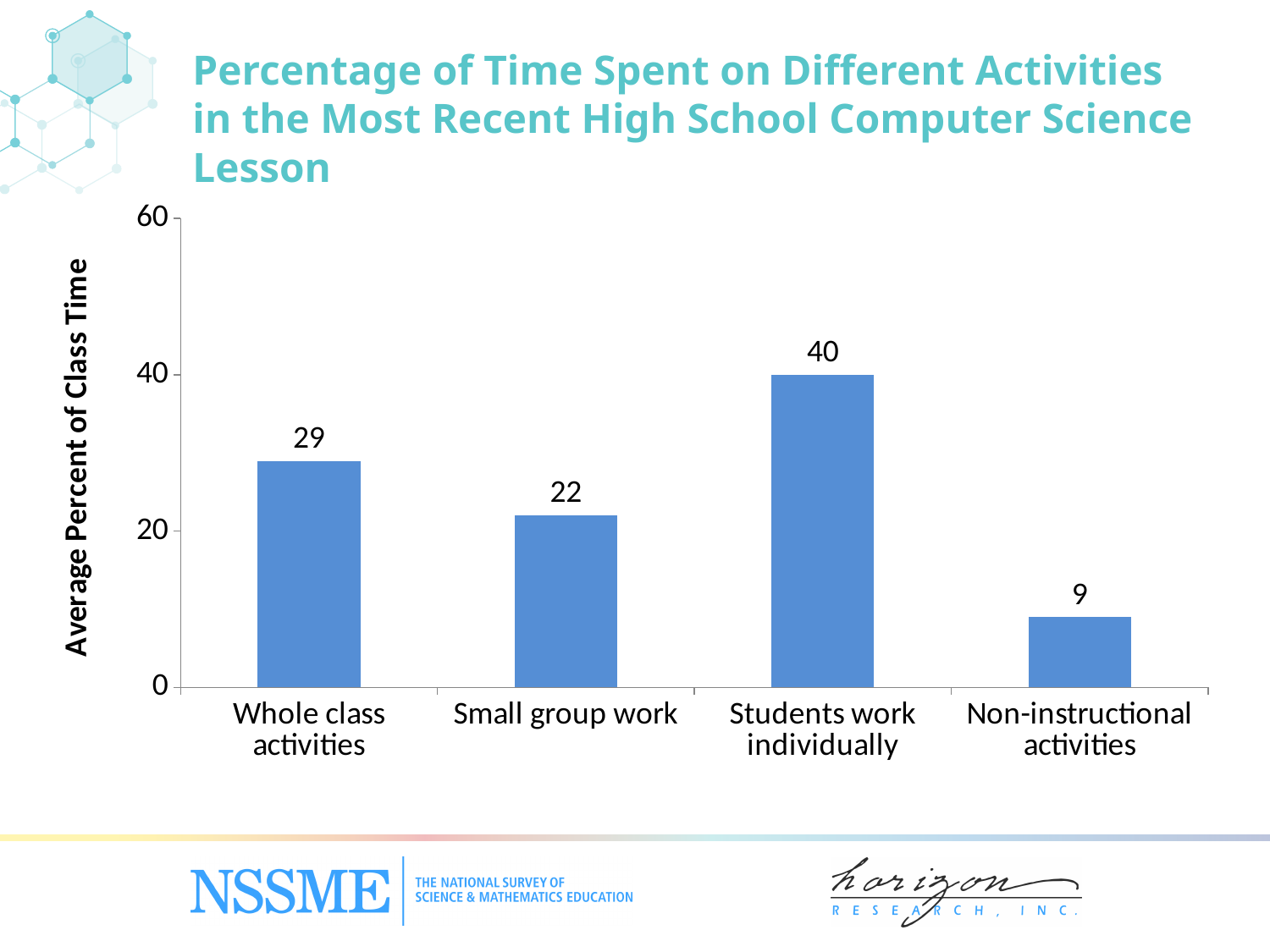
What is the value for Whole class activities? 29 What kind of chart is shown on the slide? bar chart What is the difference between the values for Whole class activities and Small group work? 7 What is the value for Non-instructional activities? 9 Which category has the highest value? Students work individually How many categories are shown on the x axis? 4 What is the value for Small group work? 22 Is the value for Students work individually greater or less than 20? greater Which category has the lowest value? Non-instructional activities What is the difference between the values for Students work individually and Whole class activities? 11 What is the value for Students work individually? 40 Which is larger, the value for Small group work or the value for Non-instructional activities? Small group work